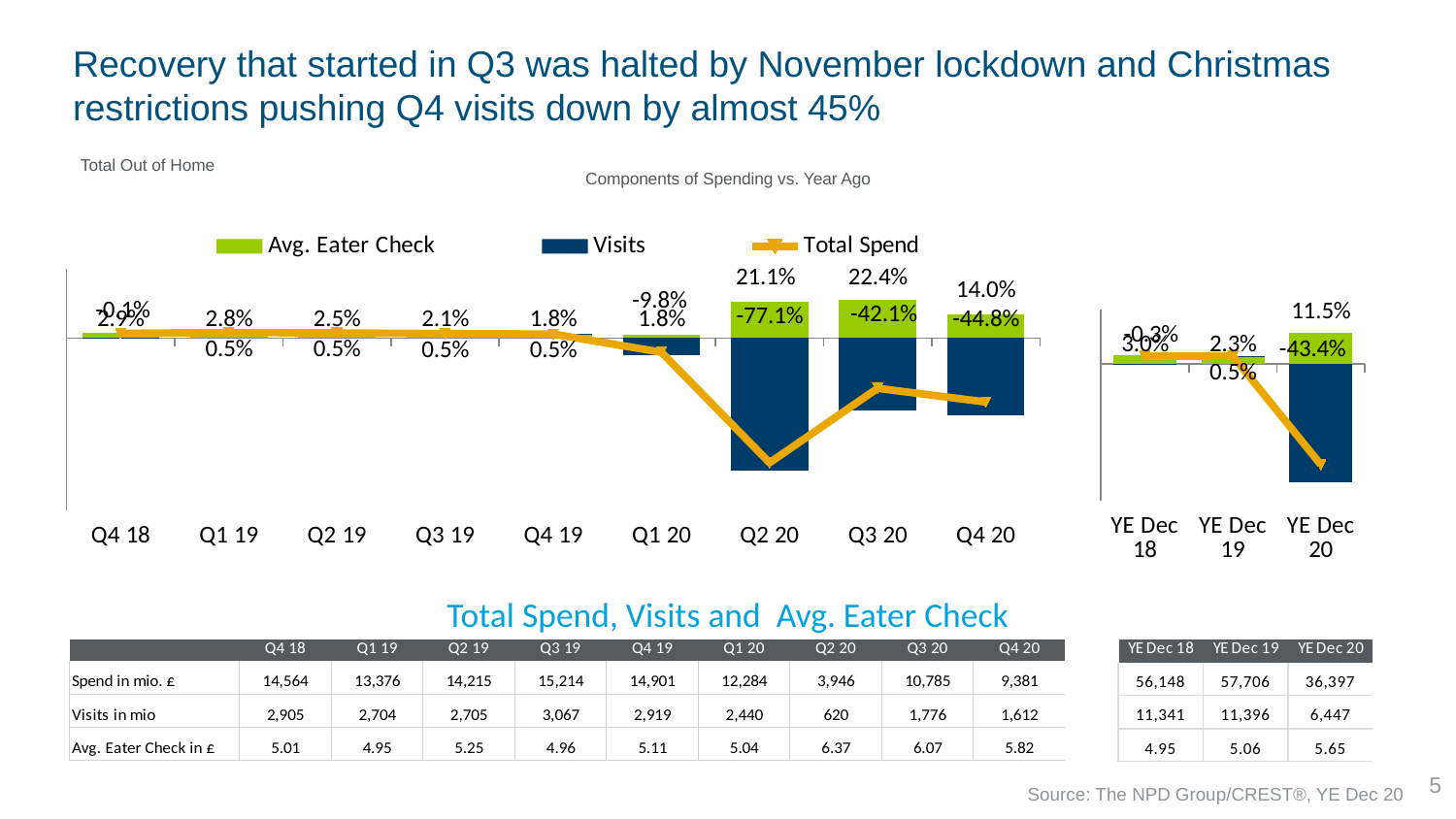
In the quarterly chart, is the Visits value for Q3 20 or Q4 20 larger? Q3 20 In the yearly chart on the right, what is the Visits value for YE Dec 20? -43.4% In the quarterly chart, what is the difference between the Avg. Eater Check values for Q3 20 and Q4 20? 8.4% In the quarterly chart, which quarter has the lowest Visits value? Q2 20 In the quarterly chart, what is the Avg. Eater Check value for Q3 20? 22.4% In the quarterly chart, which quarter has the highest Avg. Eater Check value? Q3 20 In the quarterly chart, what is the Visits value for Q1 20? -9.8% In the yearly chart on the right, what is the Avg. Eater Check value for YE Dec 20? 11.5% In the quarterly chart, what is the Visits value for Q4 20? -44.8% How many series does the legend of the quarterly chart list? 3 How many quarters are shown on the x axis of the quarterly chart? 9 In the quarterly chart (Components of Spending vs. Year Ago), what is the Visits value for Q2 20? -77.1%